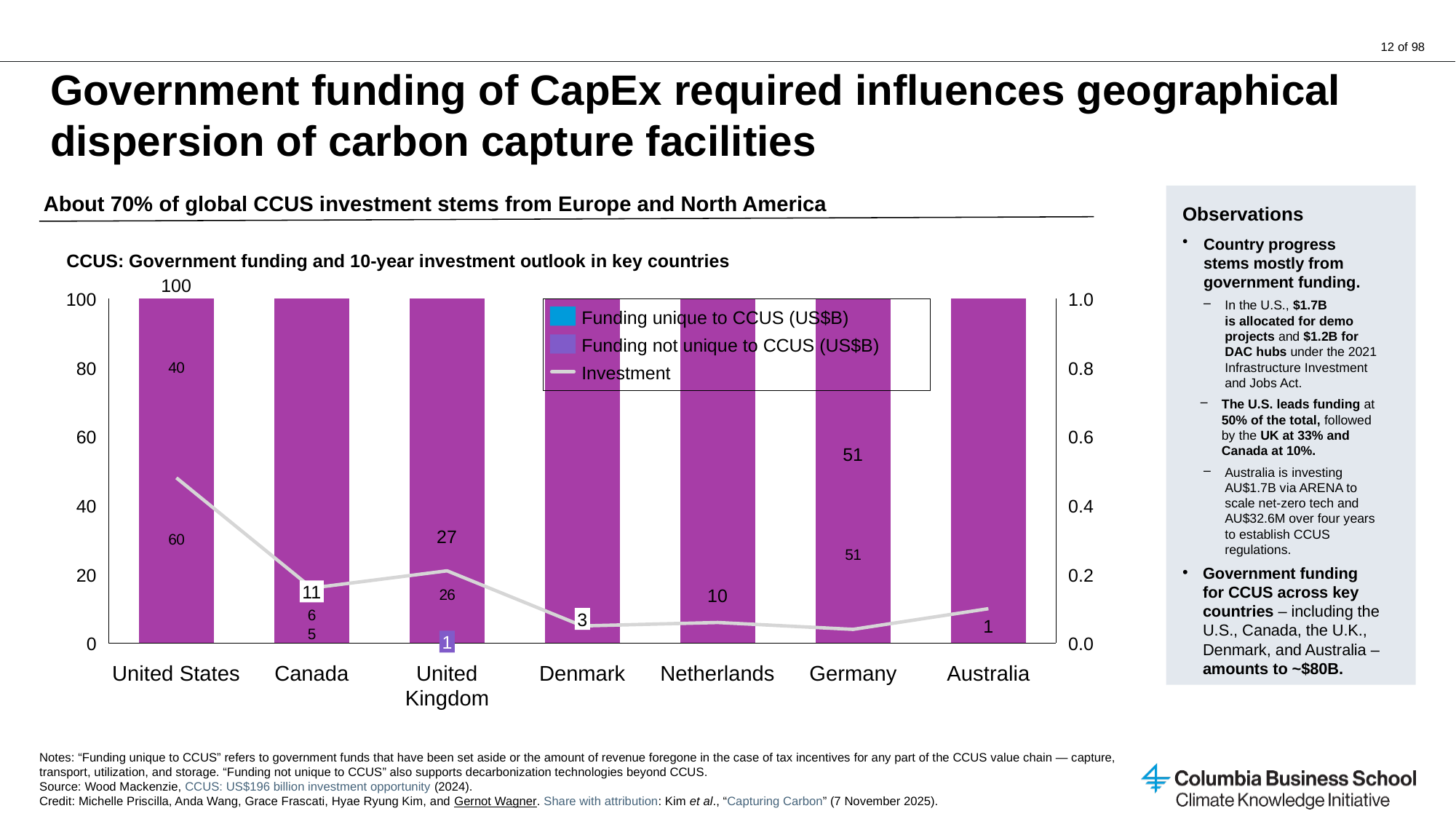
How many series does the chart legend list? 3 Which series in the legend is drawn as a line rather than bars? Investment How many countries are shown on the x axis of the chart? 7 Which has the larger Investment line value, the United Kingdom or Germany? United Kingdom Is the Investment line value for Canada greater or less than 0.4 on the right axis? less Is the Investment line value for Denmark greater or less than 0.2 on the right axis? less What is the title of the chart? CCUS: Government funding and 10-year investment outlook in key countries What is the maximum value shown on the right-hand axis of the chart? 1.0 Which country has the highest value on the Investment line? United States Is the Investment line value for the United States greater or less than 0.4 on the right axis? greater Does the Investment line rise or fall from the United States to Canada? fall Which has the larger Investment line value, the United States or Canada? United States